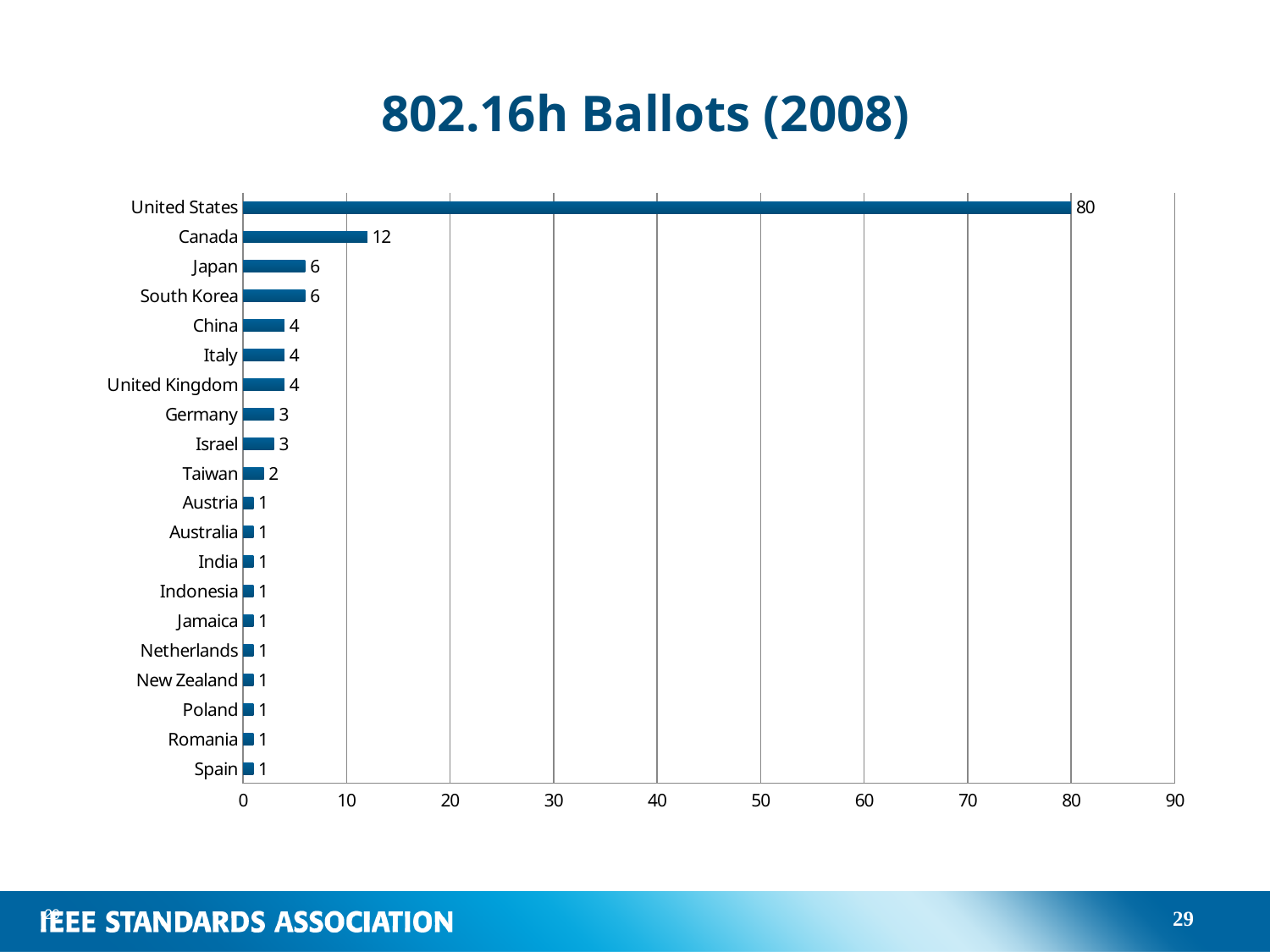
What kind of chart is shown on the slide? Bar chart What is the value for Taiwan? 2 What is the difference between the values for Japan and China? 2 What is the value for Canada? 12 What is the difference between the values for the United States and Canada? 68 What is the title of the chart? 802.16h Ballots (2008) How many countries are shown in the chart? 20 Which country has the highest number of ballots? United States What is the value for South Korea? 6 Is the value for Canada greater or less than 10? greater What is the value for the United States? 80 Which is larger, the value for Germany or the value for Taiwan? Germany